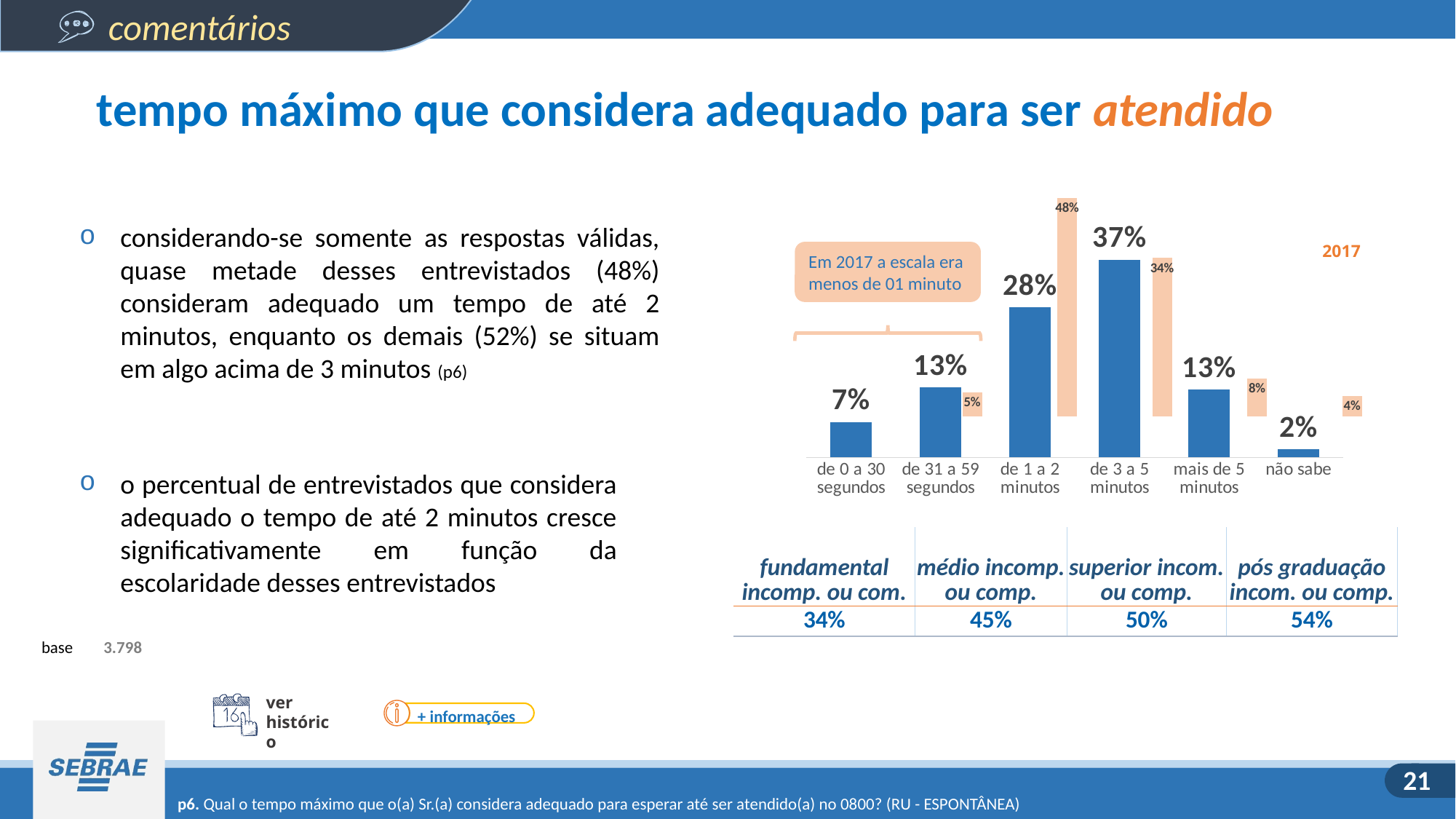
What year do the orange bars in the chart represent? 2017 What is the difference between the current value and the 2017 value for 'de 1 a 2 minutos'? 20 percentage points What was the 2017 value (orange bar) for 'de 1 a 2 minutos'? 48% Which category has the highest current (blue bar) value? de 3 a 5 minutos For 'mais de 5 minutos', which is larger: the current value or the 2017 value? the current value (13%) What type of chart is used to show the maximum adequate waiting time? bar chart What is the difference between the current values for 'de 3 a 5 minutos' and 'de 0 a 30 segundos'? 30 percentage points What is the current (blue bar) value for 'não sabe'? 2% How many categories are shown on the x axis of the bar chart? 6 What is the current (blue bar) value for 'de 1 a 2 minutos'? 28% Which category has the lowest current (blue bar) value? não sabe What percentage of respondents consider 'de 3 a 5 minutos' the maximum adequate waiting time in the current survey (blue bars)? 37%